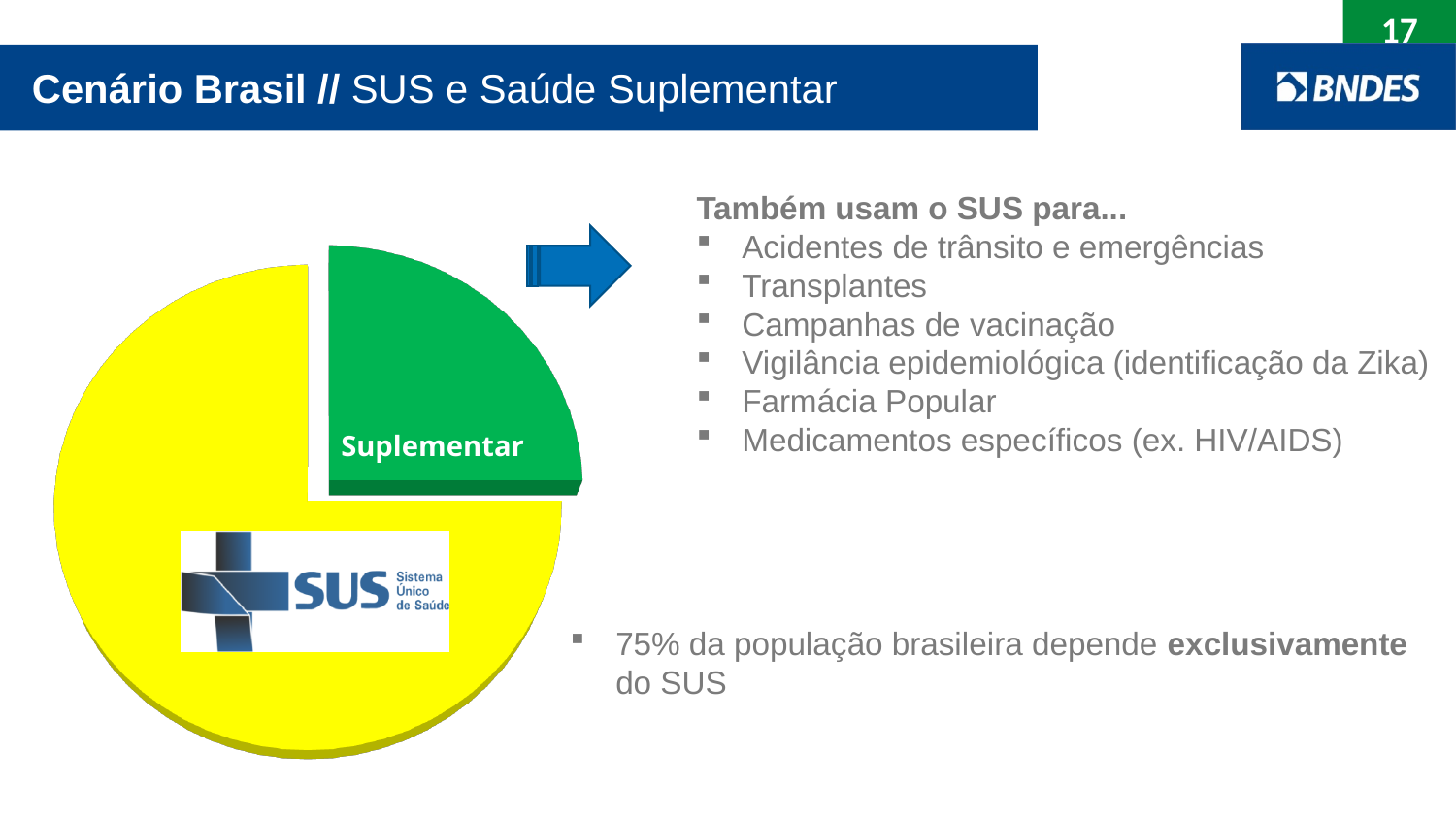
How many slices does the pie chart have? 2 What kind of chart is shown on the slide? pie chart What colour is the Suplementar slice of the pie chart? green Which slice of the pie chart is pulled out (exploded) from the rest of the pie? Suplementar Which slice of the pie chart is the largest? SUS Which slice of the pie chart is the smallest? Suplementar Which slice is larger, SUS or Suplementar? SUS